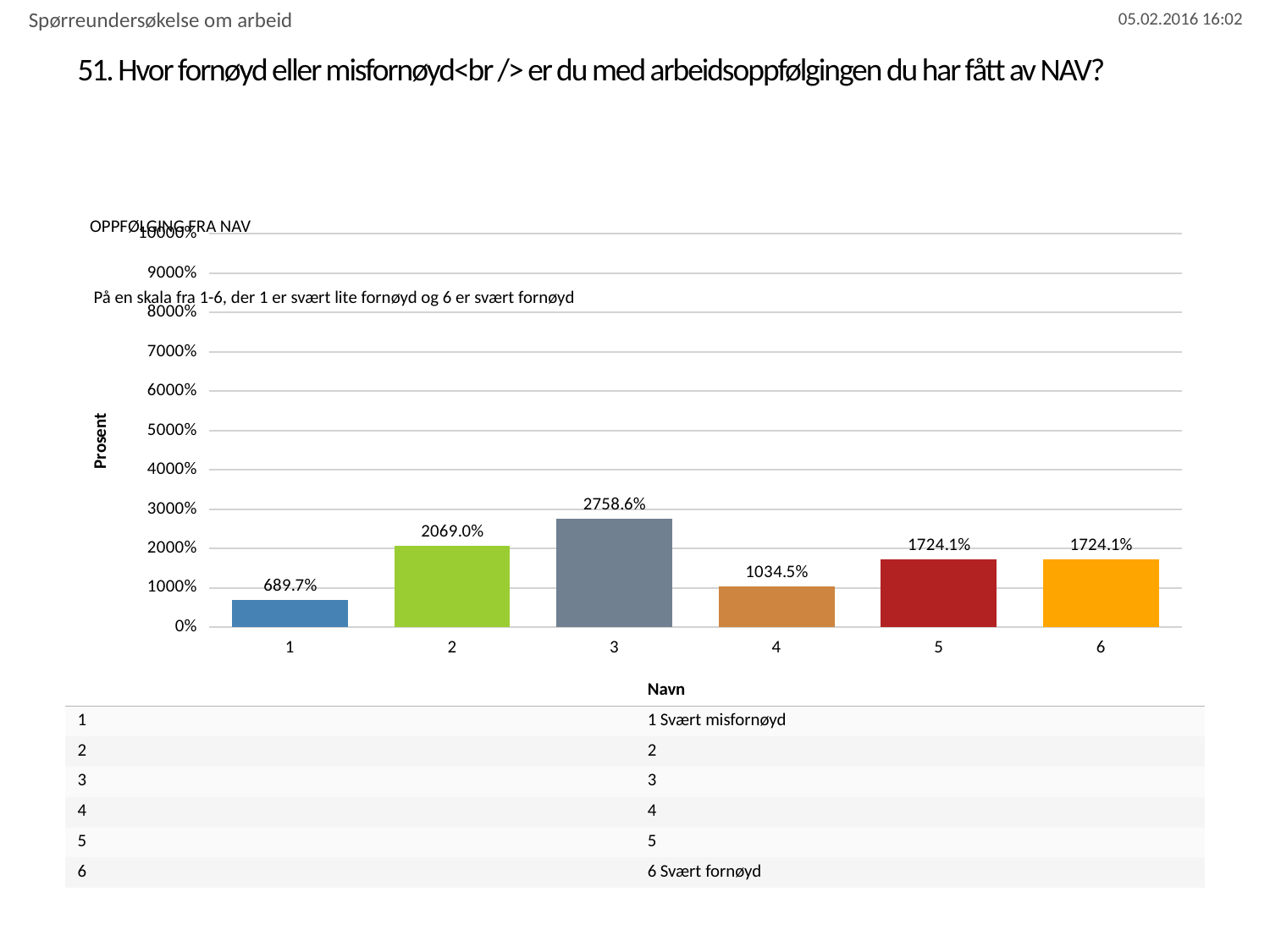
What is the value for category 1? 689.7% What is the difference between the values for category 3 and category 2? 689.6% Which is larger, the value for category 2 or the value for category 4? 2 What is the label of the y axis? Prosent Is the value for category 2 greater or less than 1000%? greater What kind of chart is shown on the slide? bar chart Which category has the lowest value? 1 What is the value for category 3? 2758.6% Which category has the highest value? 3 What is the value for category 4? 1034.5% What is the difference between the values for category 5 and category 1? 1034.4% How many categories are shown on the x axis? 6